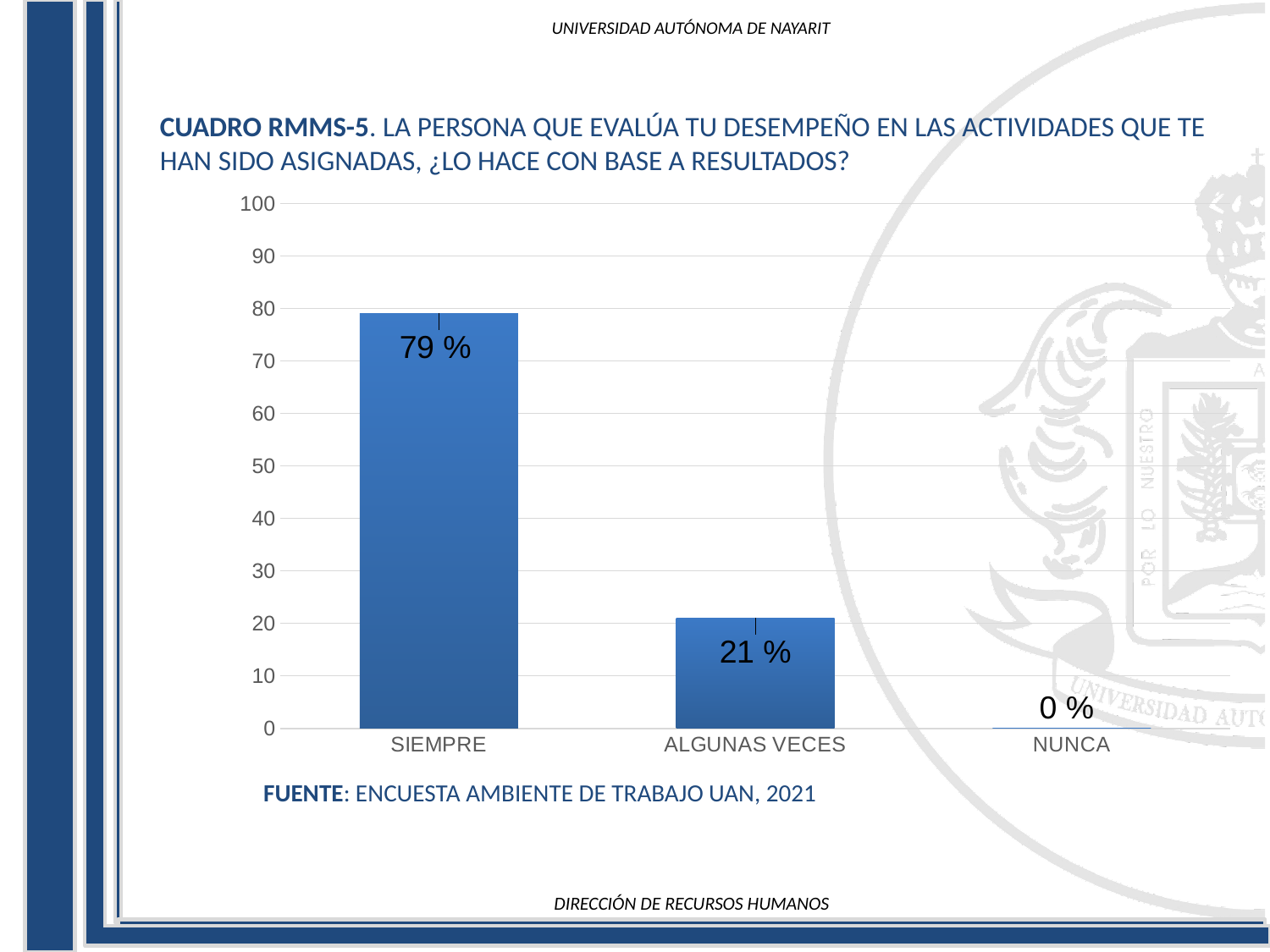
What is the value for ALGUNAS VECES? 21 % Do the values rise or fall from left to right along the x axis? fall Is the value for ALGUNAS VECES greater or less than 30? less Which category has the highest value? SIEMPRE Which category has the lowest value? NUNCA What is the value for SIEMPRE? 79 % Which is larger, the value for ALGUNAS VECES or the value for NUNCA? ALGUNAS VECES What kind of chart is shown on the slide? bar chart What is the difference between the values for SIEMPRE and ALGUNAS VECES? 58 % Is the value for SIEMPRE greater or less than 70? greater What is the value for NUNCA? 0 % How many categories are shown on the x axis? 3